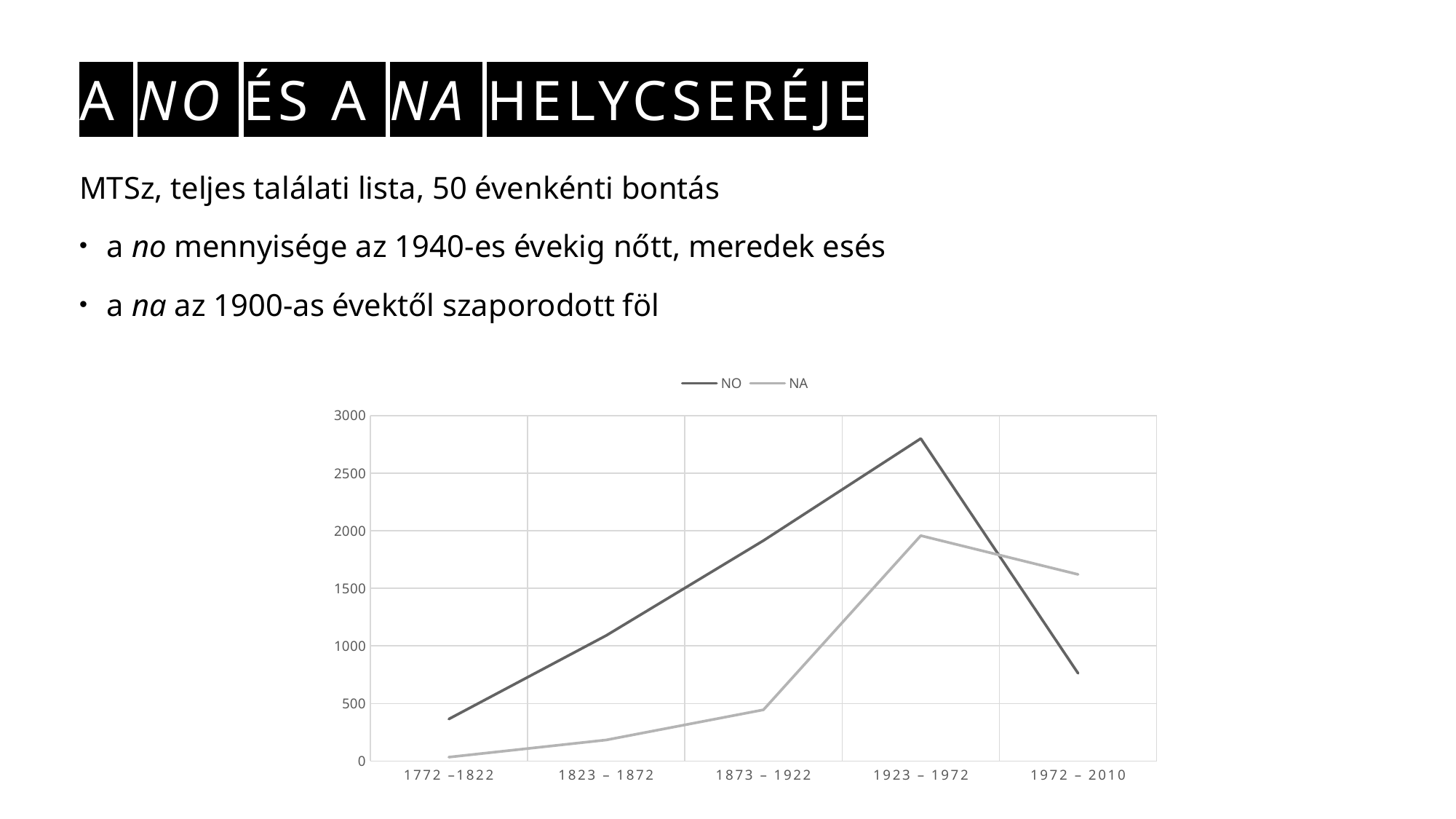
How many periods are shown on the x axis? 5 Which series has the larger value in 1972 – 2010, NO or NA? NA What kind of chart is shown on the slide? line chart Is the value for NO in 1923 – 1972 greater or less than 2500? greater In which period does the NO series reach its highest value? 1923 – 1972 Is the value for NA in 1972 – 2010 greater or less than 1500? greater Is the value for NO in 1972 – 2010 greater or less than 1000? less In which period is the NO series lowest? 1772 –1822 Does the NO series rise or fall from 1923 – 1972 to 1972 – 2010? fall In which period does the NA series reach its highest value? 1923 – 1972 How many series does the legend list? 2